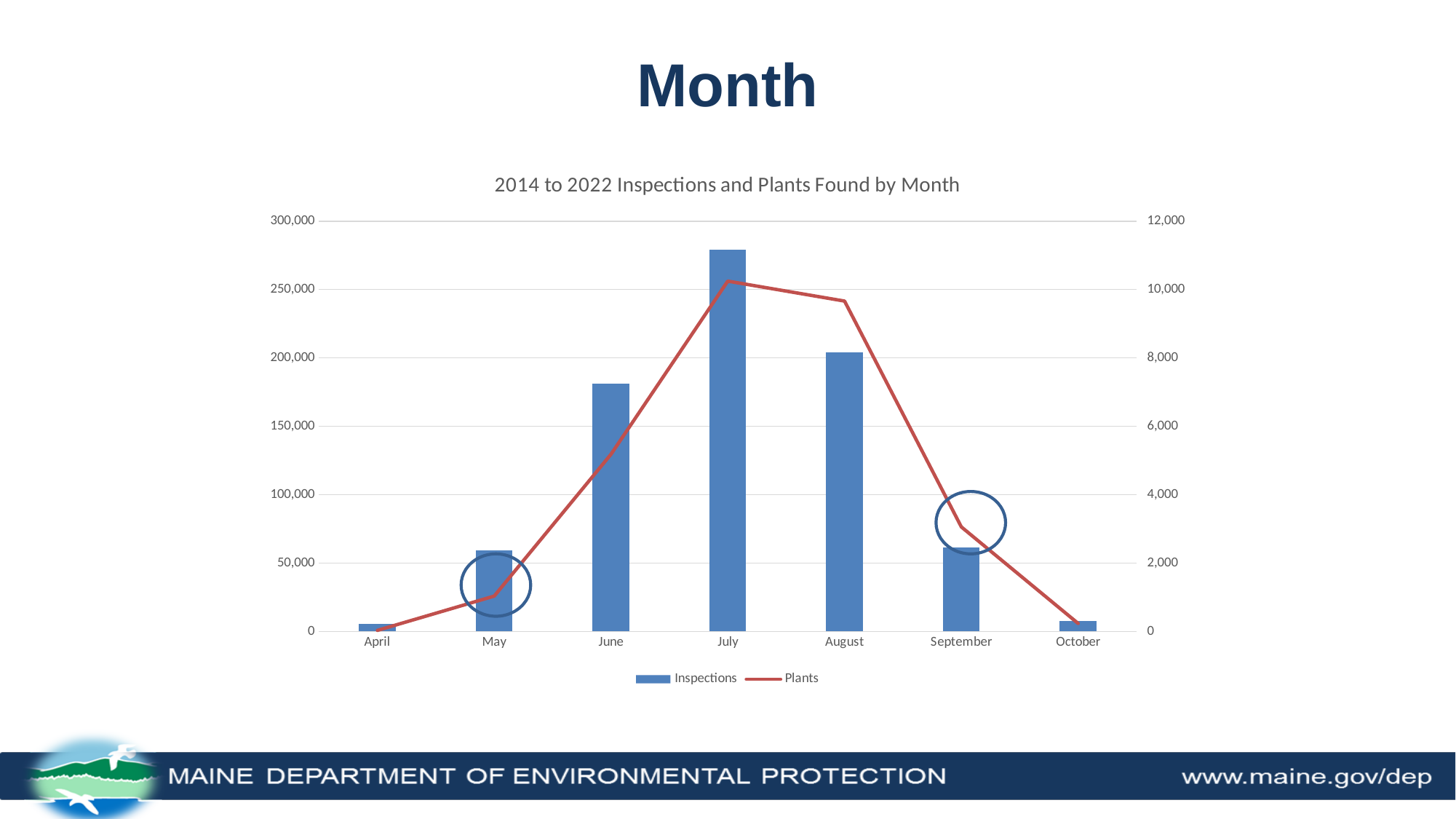
Which month has more Inspections, June or August? August Is the Plants value for September greater or less than 4,000? less Which month has the highest number of Inspections? July Is the Inspections value for July greater or less than 250,000? greater Is the Inspections value for September greater or less than 100,000? less What kind of chart is shown on the slide? Combination bar and line chart How many months are shown on the x axis? 7 What is the title of the chart? 2014 to 2022 Inspections and Plants Found by Month Which month has the highest number of Plants? July Do Inspections rise or fall from April to July? rise How many series does the legend list? 2